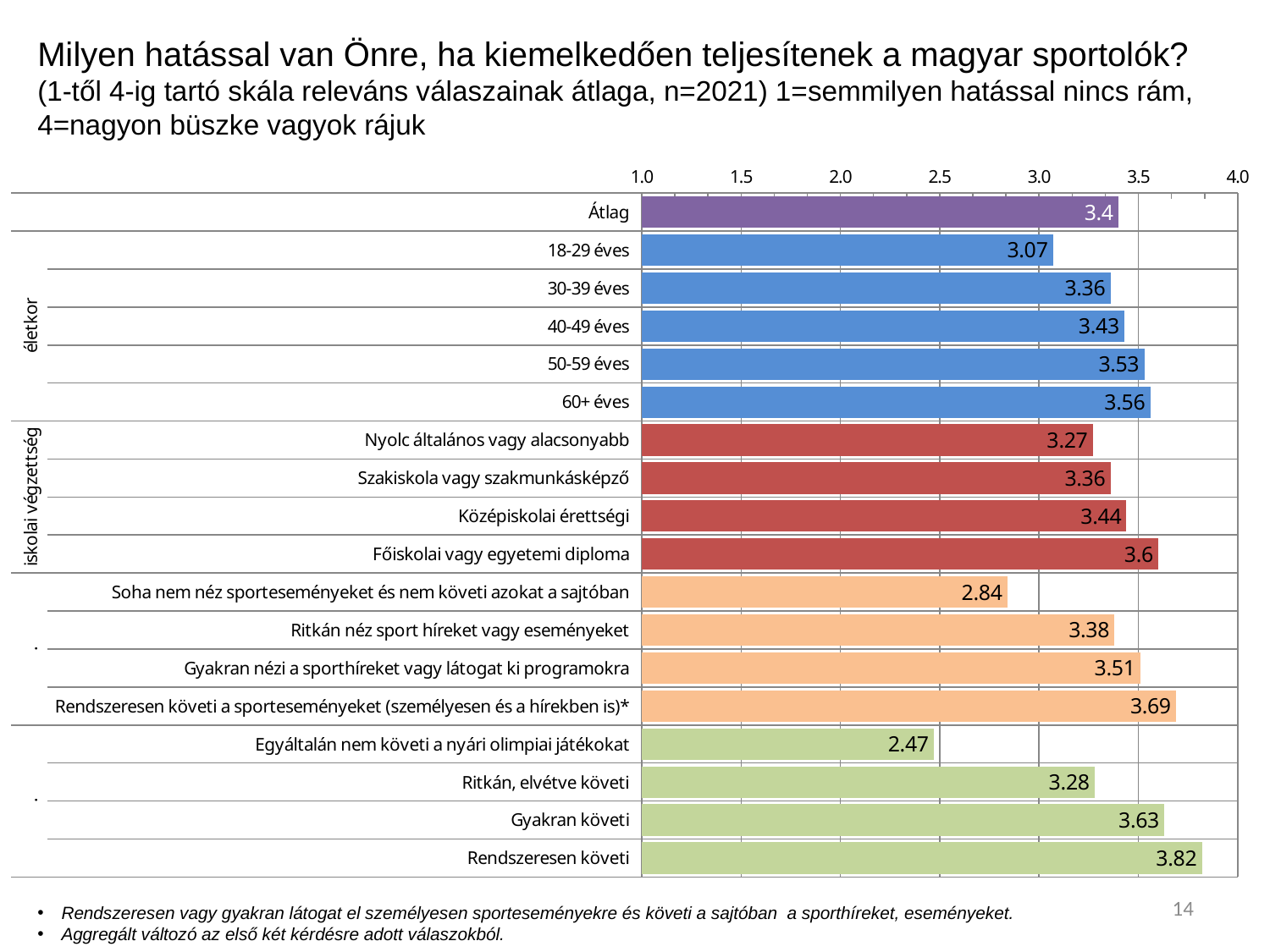
How many bars are shown on the chart? 18 What is the value for "Átlag"? 3.4 Is the value for "Soha nem néz sporteseményeket és nem követi azokat a sajtóban" greater or less than 3.0? less What kind of chart is shown on the slide? bar chart What is the value for "18-29 éves"? 3.07 Which category has the lowest value on the chart? Egyáltalán nem követi a nyári olimpiai játékokat What is the value for "Főiskolai vagy egyetemi diploma"? 3.6 Do the values rise or fall going from "18-29 éves" down to "60+ éves"? rise What is the value for "Egyáltalán nem követi a nyári olimpiai játékokat"? 2.47 Which is larger, the value for "Gyakran követi" or the value for "Gyakran nézi a sporthíreket vagy látogat ki programokra"? Gyakran követi Which category has the highest value on the chart? Rendszeresen követi What is the difference between the values for "60+ éves" and "18-29 éves"? 0.49